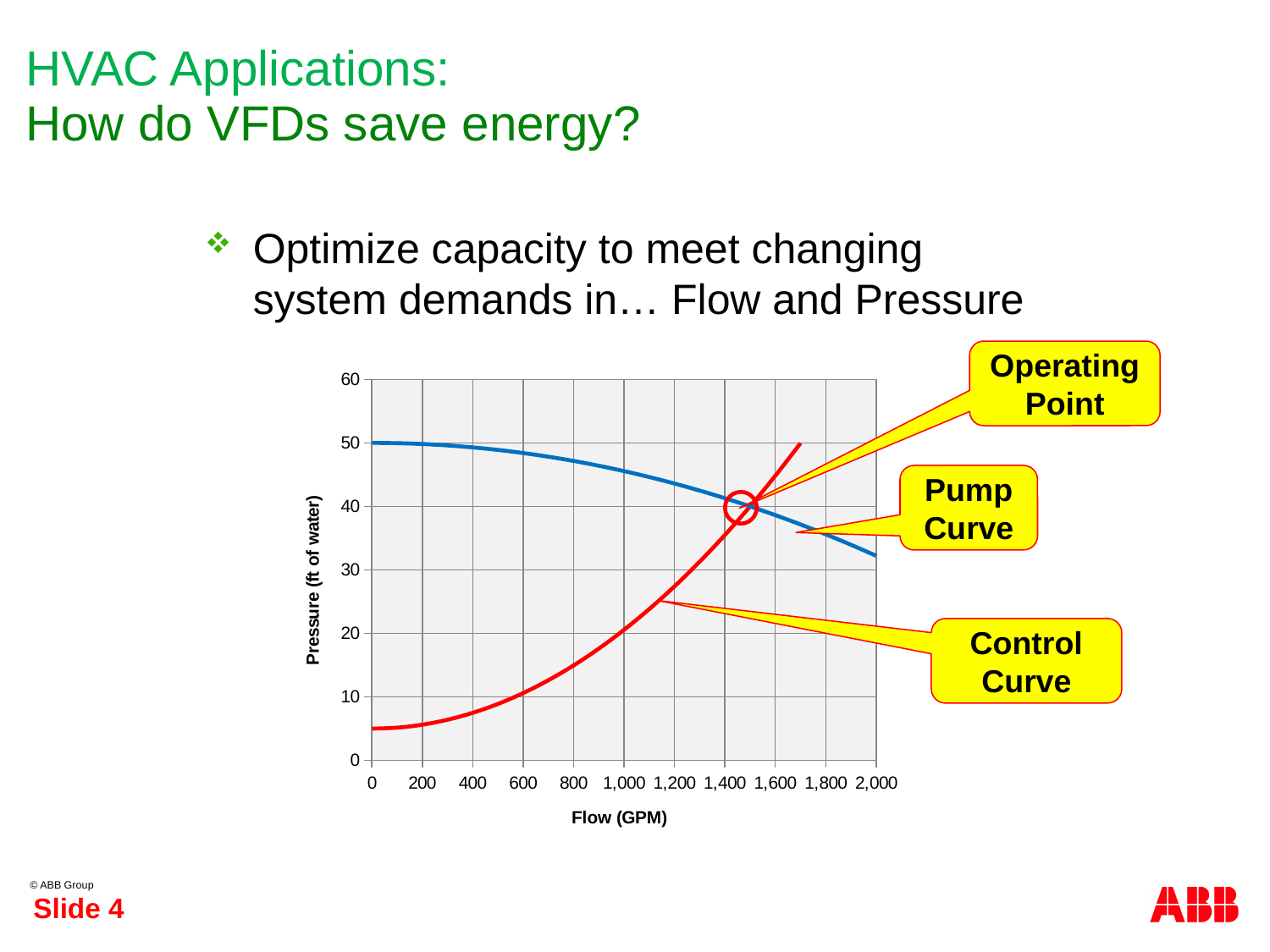
How many curves are plotted on the chart? 2 What kind of chart is shown on the slide? line chart What is the title of the x axis of the chart? Flow (GPM) Is the pressure on the Pump Curve at 1,000 GPM greater or less than 40? greater At a flow of 600 GPM, which curve shows the higher pressure, the Pump Curve or the Control Curve? Pump Curve Is the pressure on the Control Curve at 1,000 GPM greater or less than 30? less What is the pressure on the Pump Curve at a flow of 0 GPM? 50 Is the flow at the Operating Point greater or less than 1,400 GPM? greater Does the Pump Curve rise or fall as flow increases? fall Does the Control Curve rise or fall as flow increases? rise What is the title of the y axis of the chart? Pressure (ft of water)